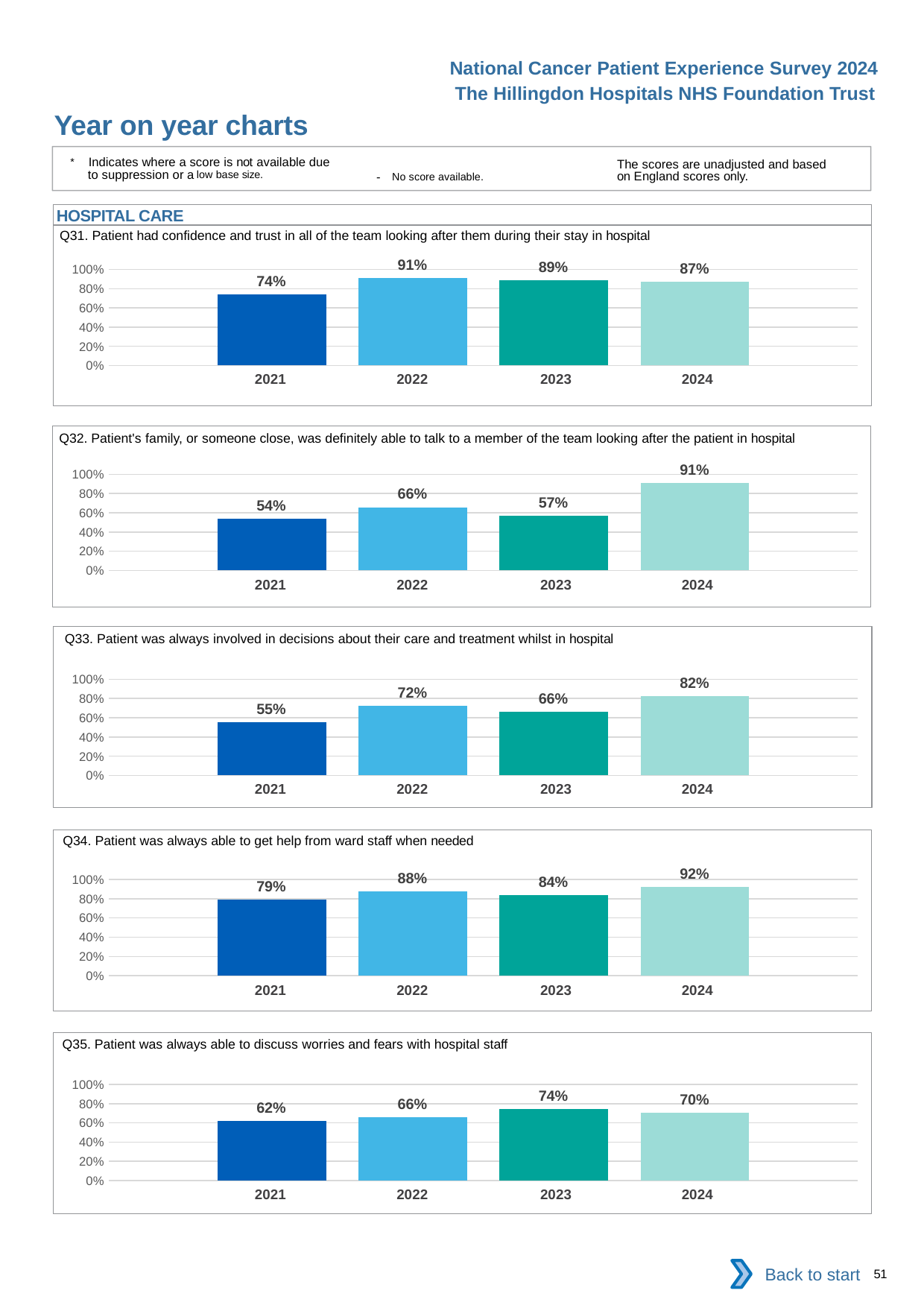
In the Q31 chart, what is the value for 2022? 91% How many years are shown in the Q31 chart? 4 In the Q33 chart, which year has the lowest value? 2021 In the Q35 chart, which year has the highest value? 2023 What type of chart is the Q33 chart? Bar chart In the Q31 chart, do the values rise or fall from 2022 to 2024? Fall In the Q32 chart, what is the difference between the 2024 and 2023 values? 34% In the Q33 chart, what is the value for 2024? 82% In the Q32 chart, which year has the highest value? 2024 In the Q35 chart, what is the value for 2021? 62% In the Q34 chart, what is the difference between the 2024 and 2021 values? 13% In the Q34 chart, which is larger, the value for 2022 or the value for 2023? 2022